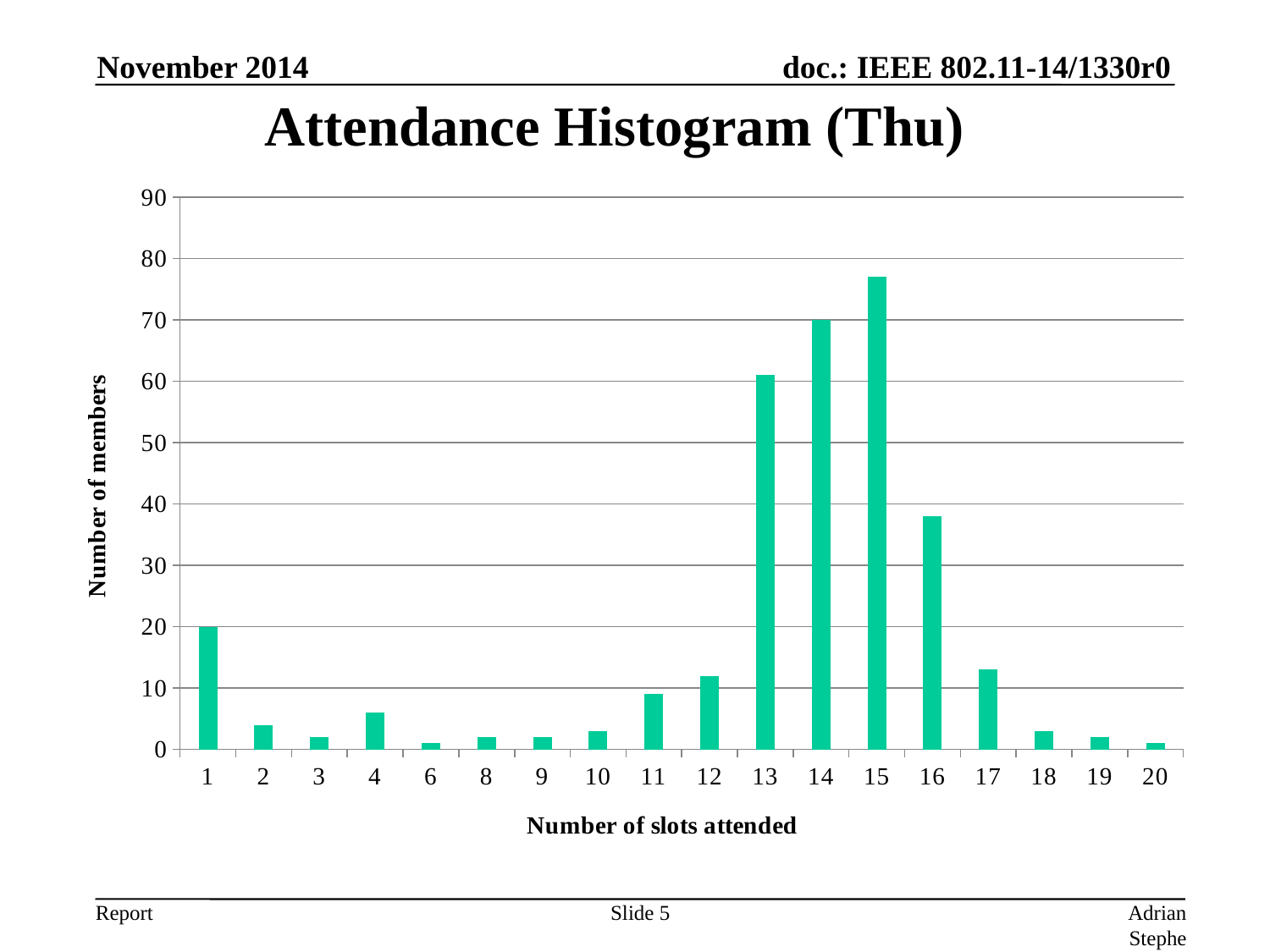
What is the number of members for 14 slots attended? 70 What type of chart is shown on the slide? bar chart Is the number of members for 16 slots attended greater or less than 40? less Which has more members: 13 slots attended or 16 slots attended? 13 What is the number of members for 1 slot attended? 20 Which number of slots attended has the highest number of members? 15 What is the label of the vertical axis? Number of members Is the number of members for 15 slots attended greater or less than 70? greater Do the values rise or fall along the x axis from 15 slots attended to 20 slots attended? fall What is the difference between the number of members for 14 slots attended and for 1 slot attended? 50 How many categories (number of slots attended) are shown on the x axis? 18 What is the title of the chart? Attendance Histogram (Thu)